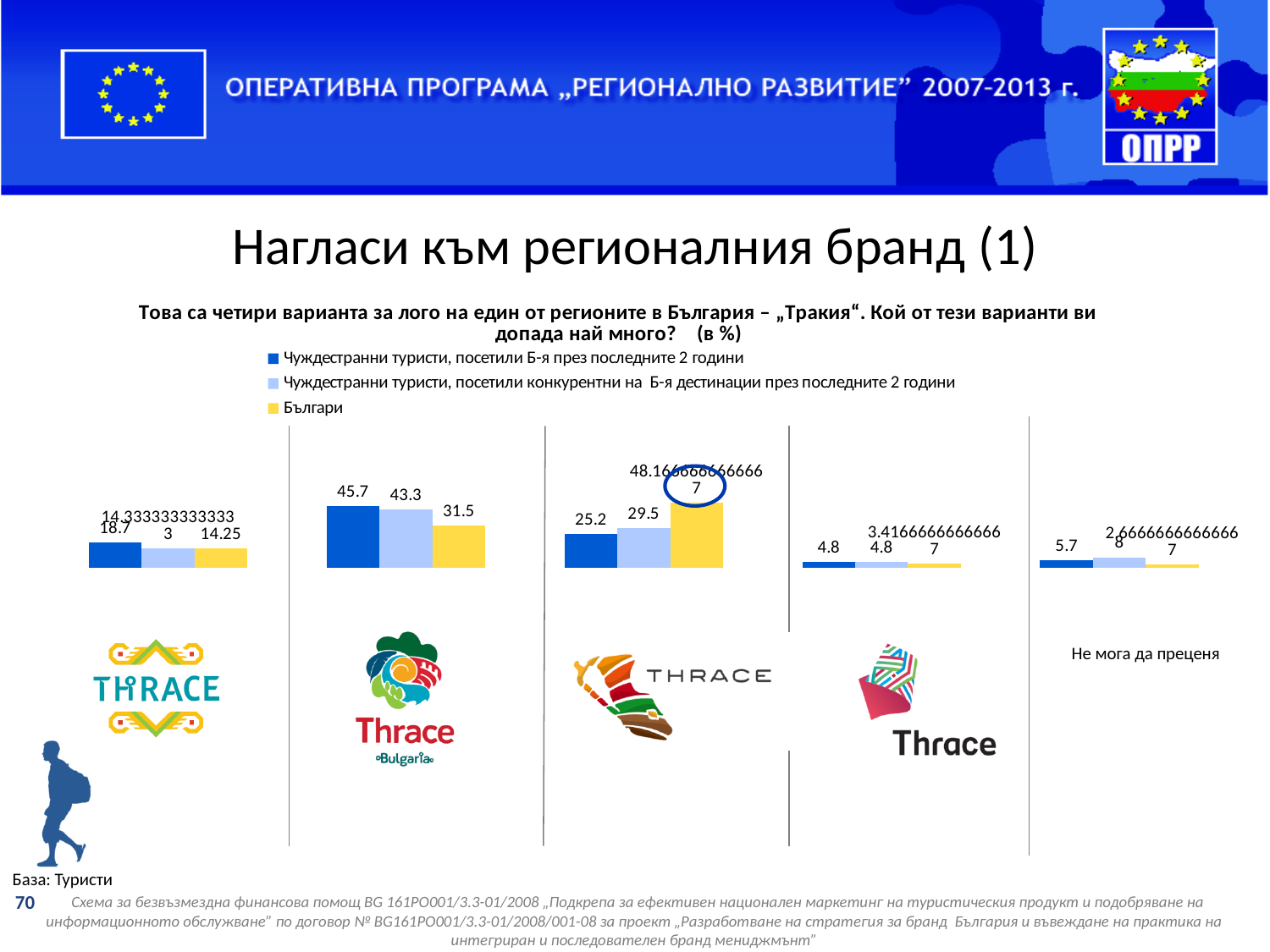
In the second group of bars from the left, what is the value for Чуждестранни туристи, посетили Б-я през последните 2 години? 45.7 How many series does the chart legend list? 3 Which group of bars has the highest value for the Българи series? the third group from the left In the third group of bars from the left, which is larger: the value for Българи or the value for Чуждестранни туристи, посетили Б-я през последните 2 години? Българи In the second group of bars from the left, what is the difference between the value for Чуждестранни туристи, посетили Б-я през последните 2 години (45.7) and the value for Българи (31.5)? 14.2 Which group of bars has the highest value for Чуждестранни туристи, посетили Б-я през последните 2 години? the second group from the left For the category 'Не мога да преценя', what is the value for Българи? 2.66666666666667 In the third group of bars from the left, what is the value for Чуждестранни туристи, посетили конкурентни на Б-я дестинации през последните 2 години? 29.5 How many groups of bars are plotted in the chart? 5 In the second group of bars from the left, what is the value for Българи? 31.5 Which legend entry is shown in yellow? Българи What kind of chart is shown on the slide? bar chart